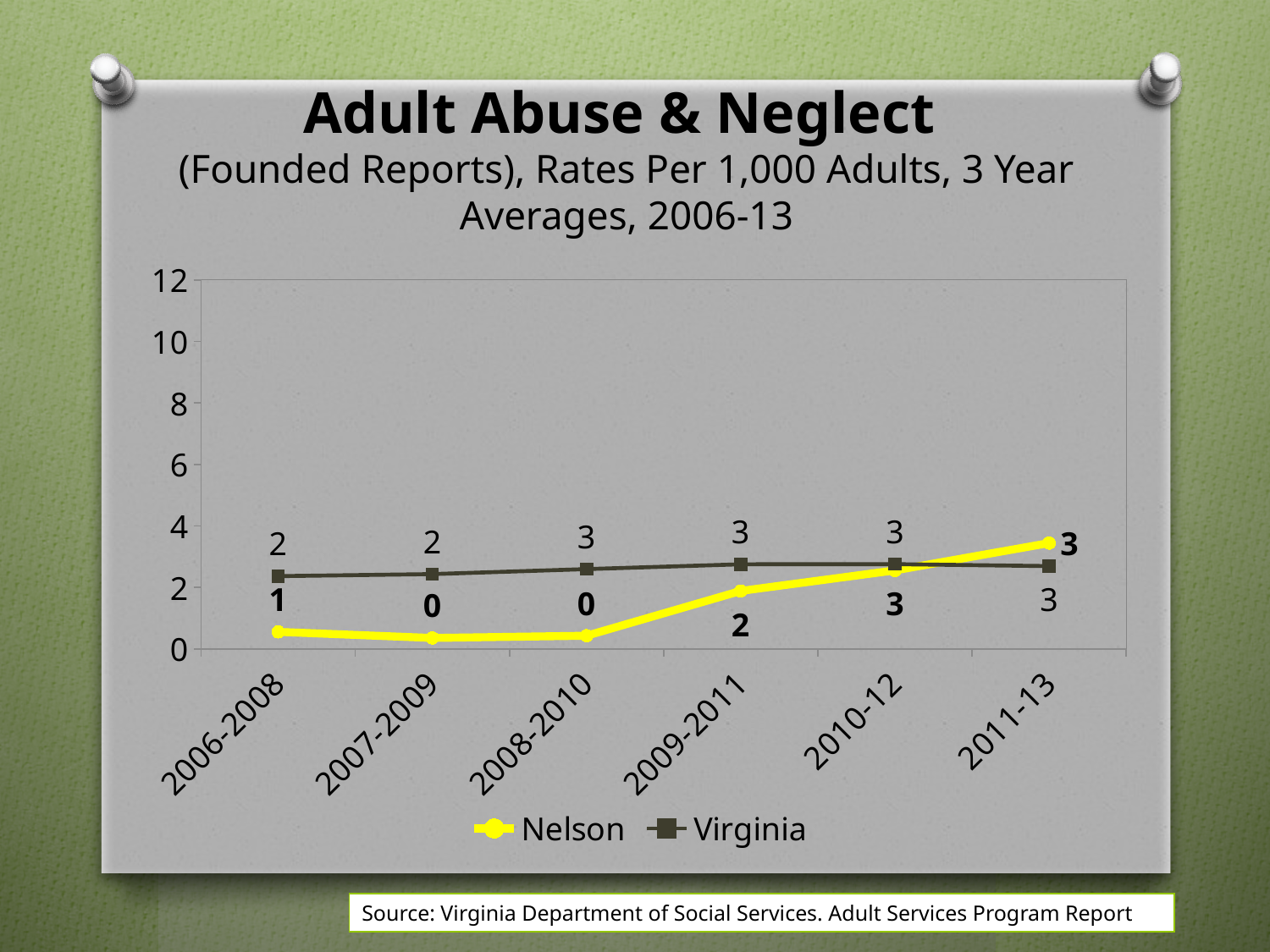
What is the difference between the Virginia and Nelson values in 2006-2008? 1 How many time periods are shown on the x axis? 6 Which series is drawn in yellow? Nelson What is the Nelson value for 2007-2009? 0 How many series does the legend list? 2 What kind of chart is shown on the slide? line chart In 2006-2008, which series has the larger value, Nelson or Virginia? Virginia What is the Nelson value for 2009-2011? 2 Does the Nelson series rise or fall from 2008-2010 to 2011-13? rise Is the Nelson value for 2011-13 greater or less than 4? less What is the Virginia value for 2006-2008? 2 What is the Virginia value for 2011-13? 3